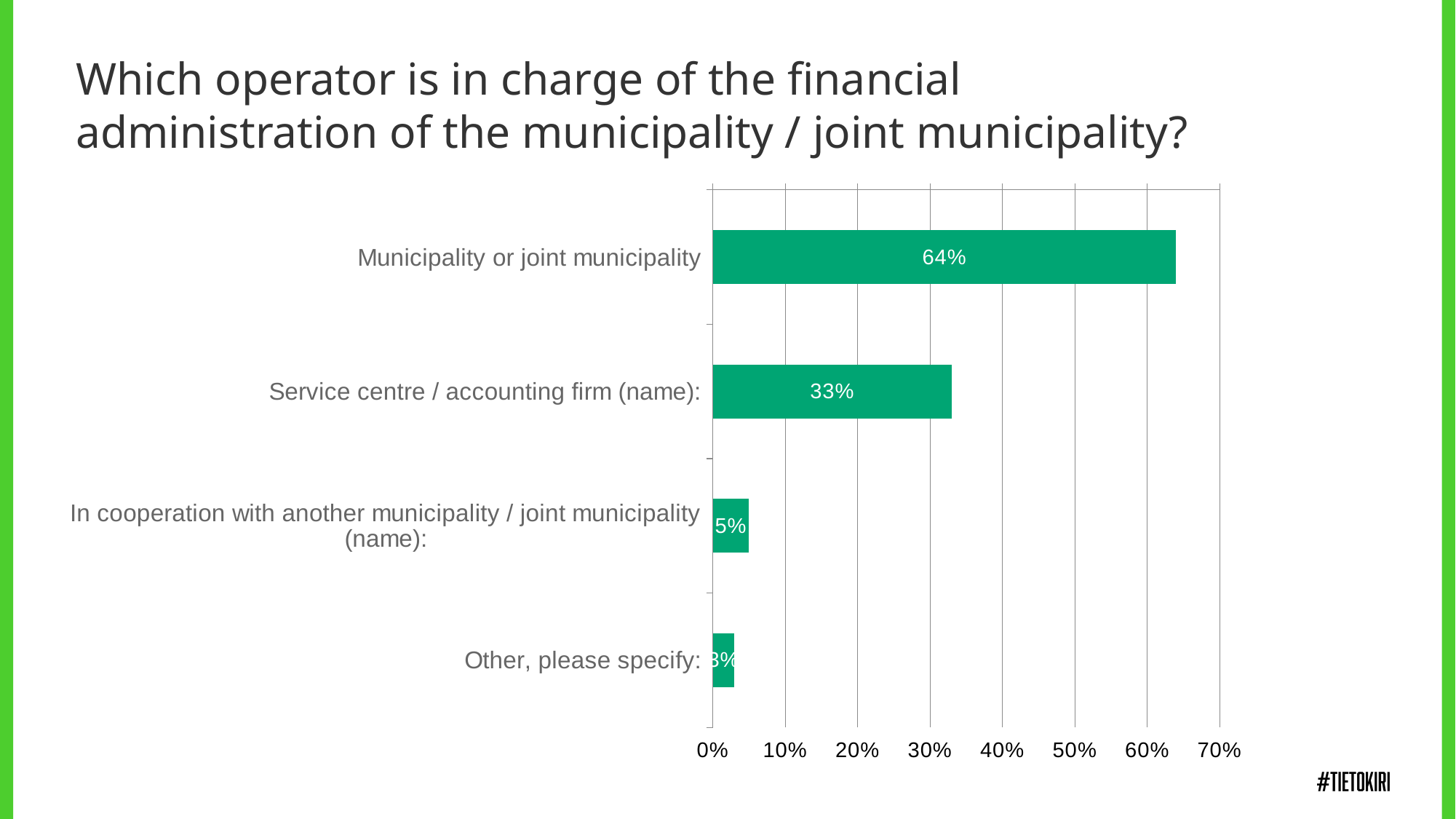
What is the value for In cooperation with another municipality / joint municipality (name):? 5% What is the difference between the values for Municipality or joint municipality and Service centre / accounting firm (name):? 31% What is the title of the slide above the chart? Which operator is in charge of the financial administration of the municipality / joint municipality? Which category has the lowest value? Other, please specify: What is the value for Municipality or joint municipality? 64% Which is larger: the value for Service centre / accounting firm (name): or the value for In cooperation with another municipality / joint municipality (name):? Service centre / accounting firm (name): Is the value for Other, please specify: greater or less than 10%? less How many categories are shown in the chart? 4 Is the value for Municipality or joint municipality greater or less than 60%? greater What kind of chart is shown on the slide? bar chart What is the value for Service centre / accounting firm (name):? 33% Which category has the highest value? Municipality or joint municipality